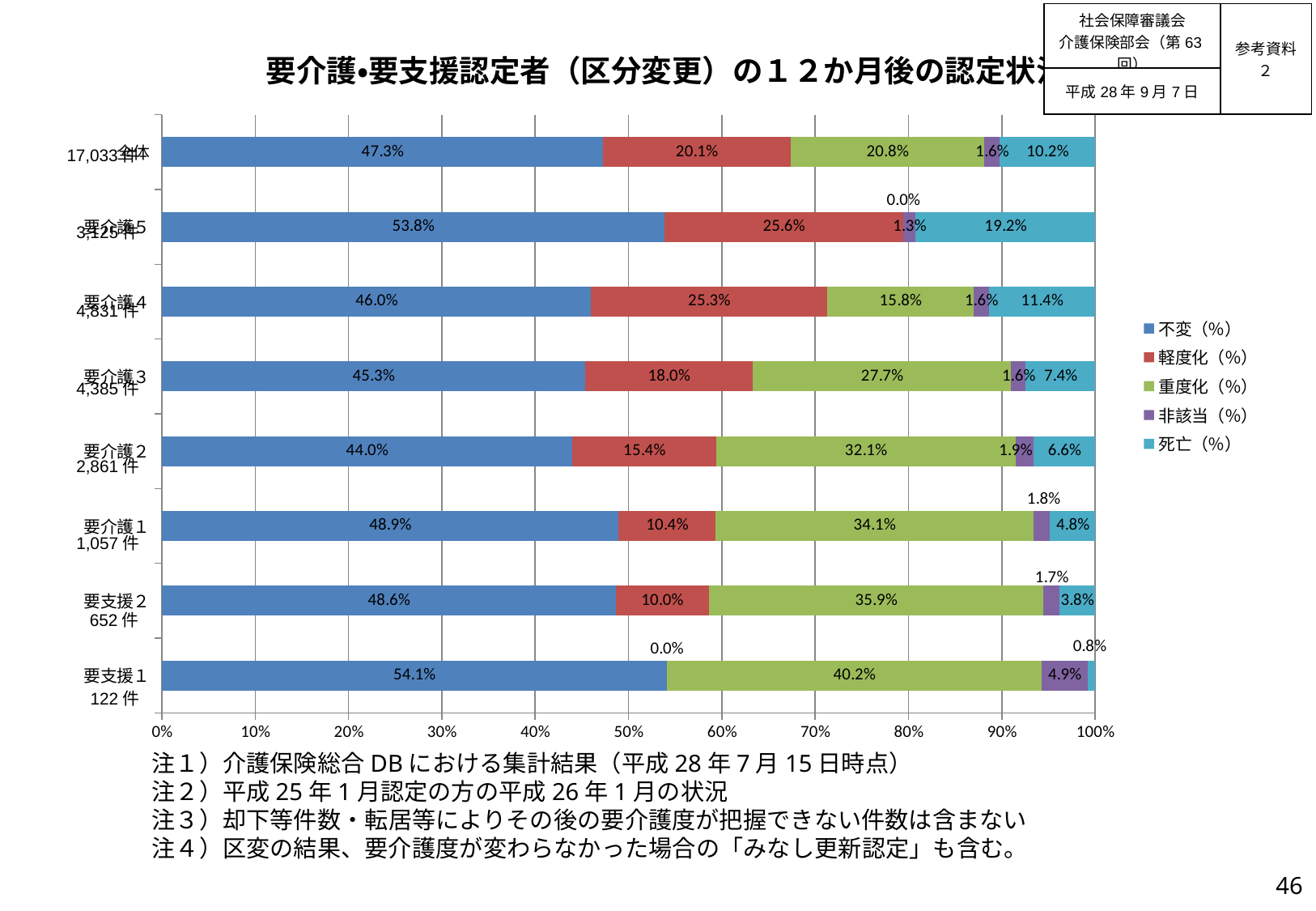
Which is larger, the 軽度化（%） value for 要介護5 or for 要介護3? 要介護5 Which category has the highest 不変（%） value? 要支援1 What is the 不変（%） value for 要介護2? 44.0% What is the difference between the 重度化（%） values for 要支援2 and 要介護4? 20.1% Which legend entry is shown in green? 重度化（%） Which category has the lowest 死亡（%） value? 要支援1 What is the 軽度化（%） value for 全体? 20.1% How many series does the legend list? 5 What kind of chart is shown on the slide? stacked bar chart What is the 重度化（%） value for 要支援1? 40.2% What is the 死亡（%） value for 要介護5? 19.2% How many categories (bars) are plotted in the chart? 8